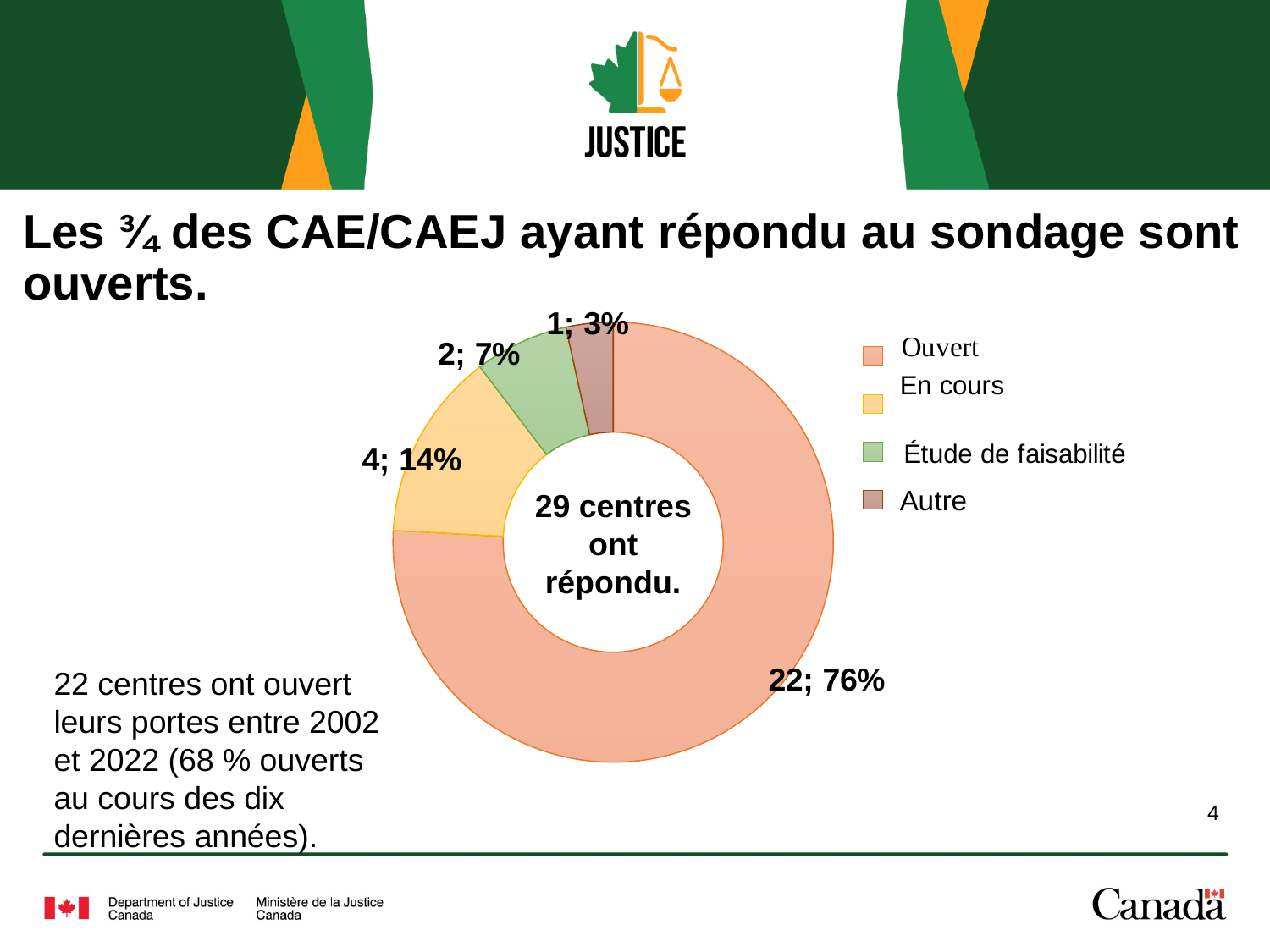
Which category has the smallest share of the chart? Autre What text is shown in the centre of the doughnut chart? 29 centres ont répondu. What kind of chart is shown on the slide? doughnut chart What percentage of the chart does 'Ouvert' represent? 76% Which category has more centres, 'En cours' or 'Étude de faisabilité'? En cours How many centres are in the 'En cours' category? 4 What percentage of the chart does 'Étude de faisabilité' represent? 7% How many centres are in the 'Autre' category? 1 How many categories does the legend list? 4 How many centres are in the 'Ouvert' category? 22 Which category has the largest share of the chart? Ouvert What is the difference in number of centres between 'Ouvert' and 'En cours'? 18